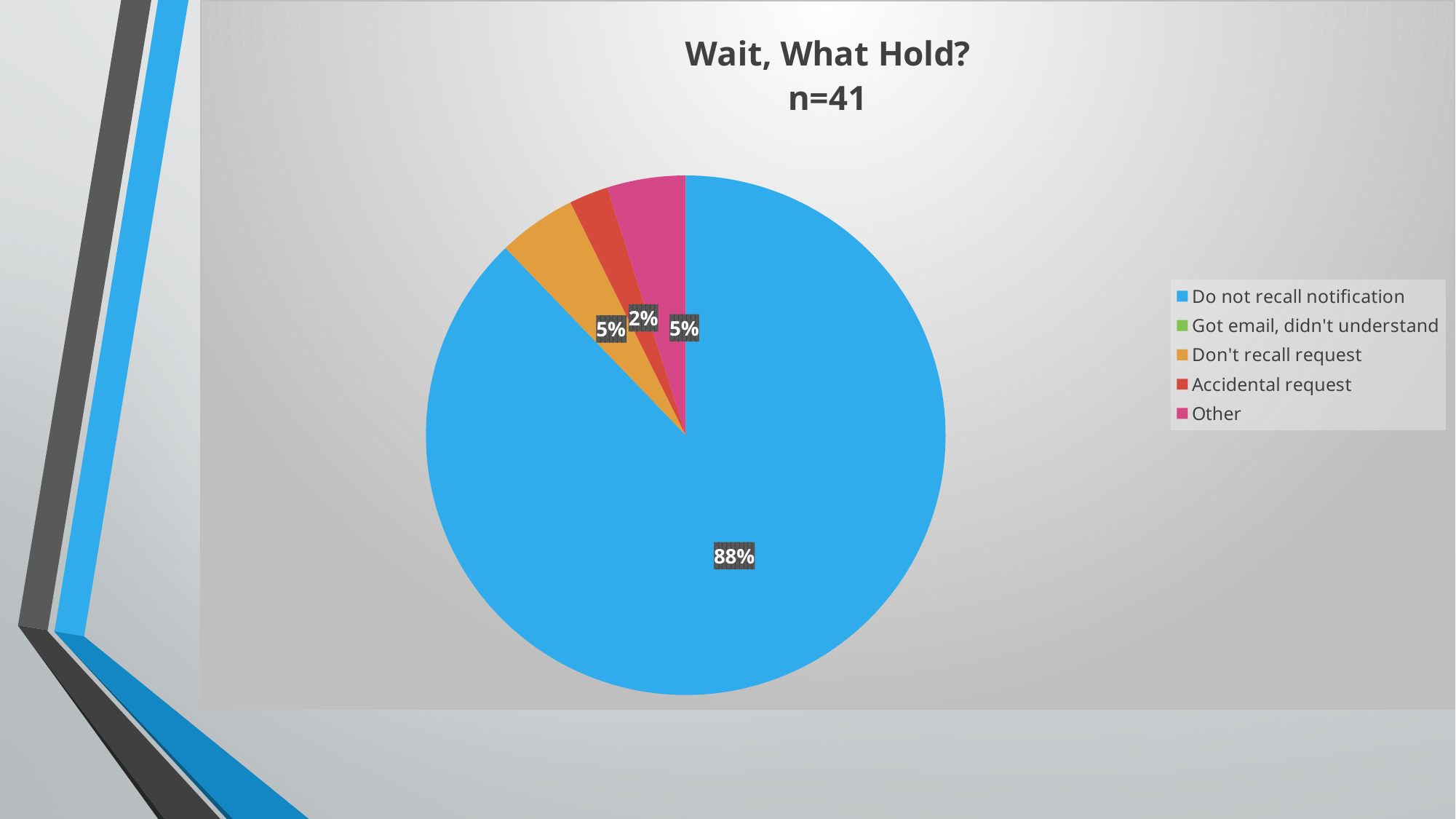
What colour is the "Do not recall notification" slice? blue What share of the pie is labelled for "Do not recall notification"? 88% What type of chart is shown on the slide? pie chart Which slice is larger, "Don't recall request" or "Accidental request"? Don't recall request What share of the pie is labelled for "Don't recall request"? 5% What is the title of the chart? Wait, What Hold? n=41 What share of the pie is labelled for "Other"? 5% Which of the labelled slices is the smallest? Accidental request What share of the pie is labelled for "Accidental request"? 2% Which category has the largest slice of the pie? Do not recall notification How many percentage points larger is the "Do not recall notification" slice than the "Other" slice? 83 How many entries does the legend list? 5